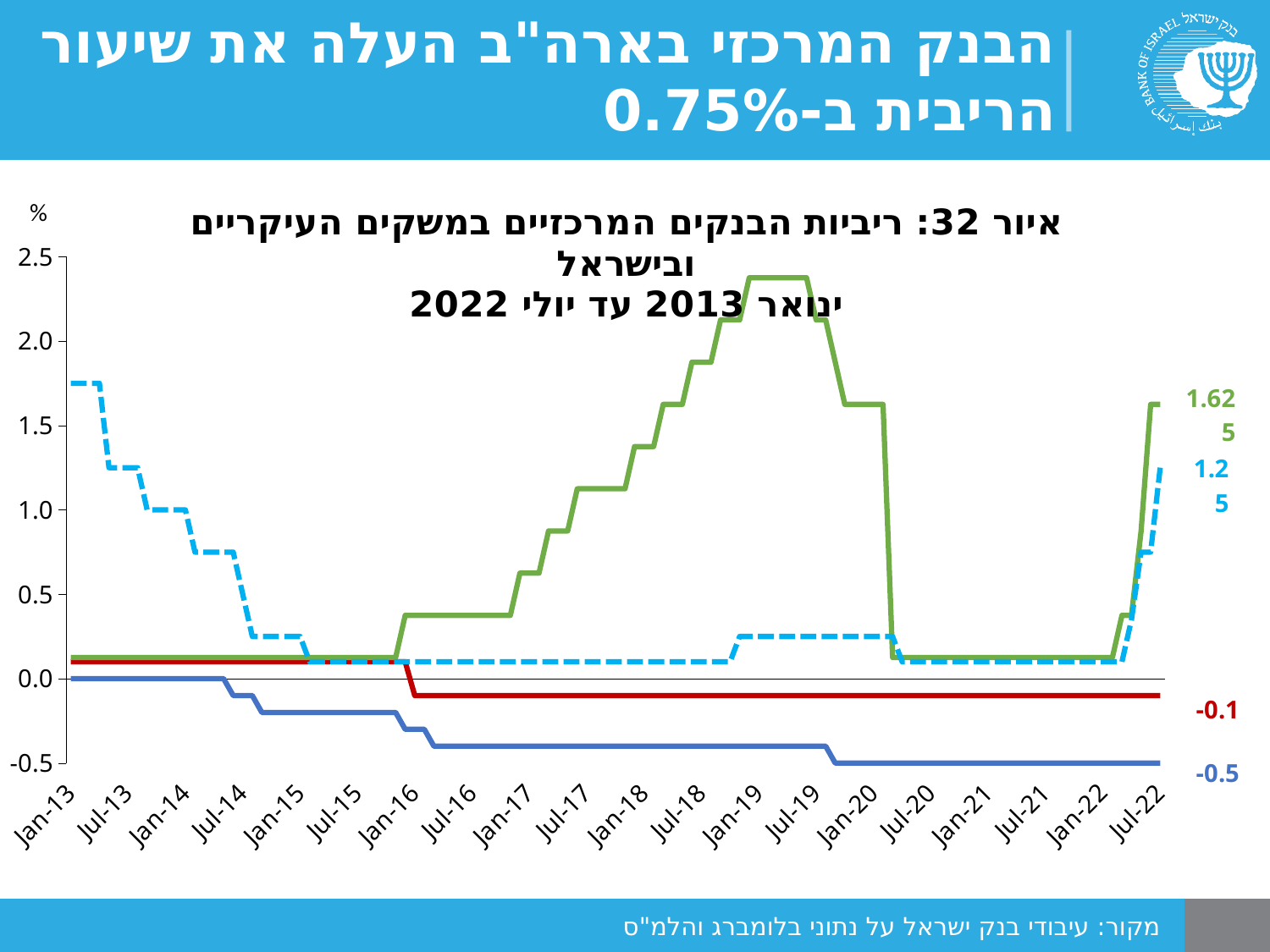
What is the difference between the final values of the green solid line and the blue dashed line? 0.375 What is the difference between the final values of the red solid line and the blue solid line? 0.4 Does the green solid line rise or fall between Jan-16 and Jan-19? Rise What unit is shown on the y axis of the chart? % What is the final value of the blue solid line? -0.5 What is the final value of the red solid line? -0.1 Is the peak value of the green solid line in 2019 greater or less than 2.0? greater What is the final value (Jul-22) of the blue dashed line? 1.25 What is the final value (Jul-22) of the green solid line? 1.625 Which line has the highest value at the end of the period (Jul-22)? The green solid line Which line has the lowest value at the end of the period (Jul-22)? The blue solid line What kind of chart is shown on the slide? Line chart